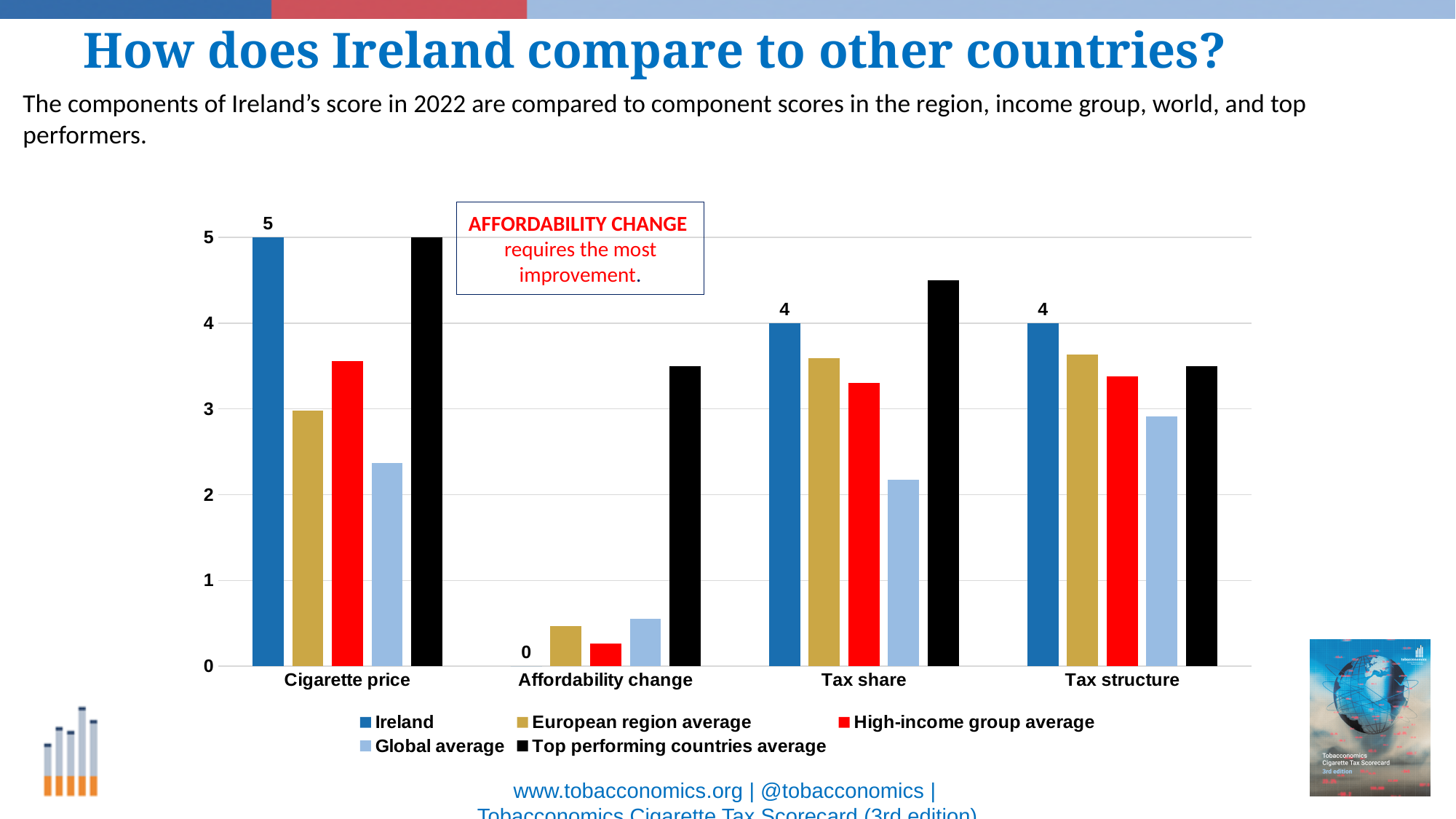
How many components (categories) are shown on the x axis? 4 According to the annotation on the chart, which component requires the most improvement? Affordability change How many series does the legend list? 5 What is the difference between Ireland's Cigarette price score and its Affordability change score? 5 What is Ireland's score for Affordability change? 0 What is Ireland's score for Tax share? 4 What is Ireland's score for Cigarette price? 5 On which component does Ireland have its lowest score? Affordability change Is the Global average for Cigarette price greater or less than 3? less Is the Top performing countries average for Affordability change greater or less than 3? greater For Cigarette price, which is larger: Ireland or the Global average? Ireland On which component does Ireland have its highest score? Cigarette price